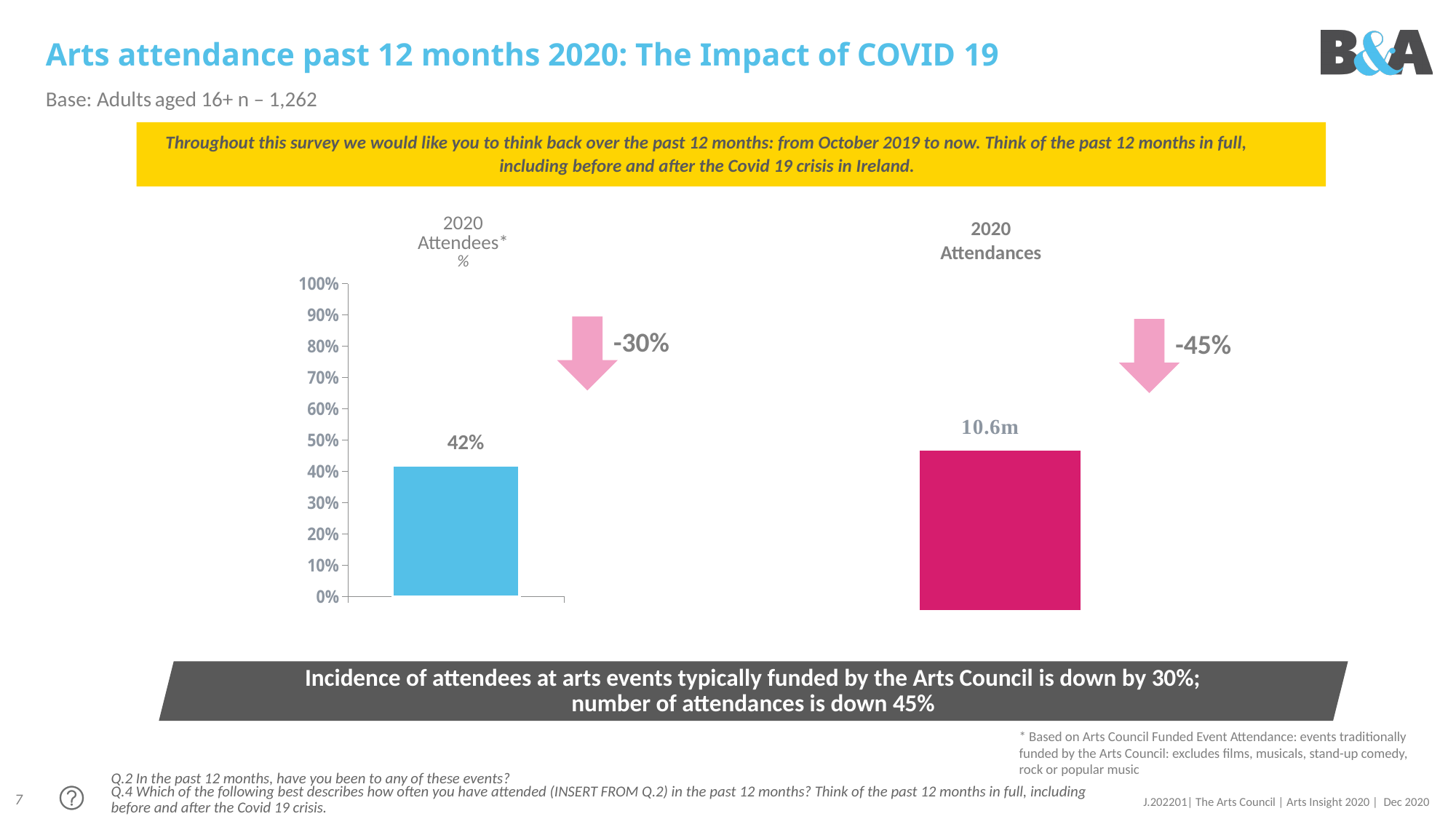
What percentage change is shown by the arrow next to the left chart titled '2020 Attendees %'? -30% What kind of chart is the left chart titled '2020 Attendees %'? bar chart What percentage change is shown by the arrow next to the right chart titled '2020 Attendances'? -45% In the left chart titled '2020 Attendees %', is the value of the bar greater or less than 50%? less What colour is the bar in the left chart titled '2020 Attendees %'? blue Which chart shows the larger percentage decline, '2020 Attendees %' or '2020 Attendances'? 2020 Attendances In the right chart titled '2020 Attendances', what value is printed above the bar? 10.6m How many bars are plotted in the right chart titled '2020 Attendances'? 1 In the left chart titled '2020 Attendees %', what value is shown for the bar? 42% How many bars are plotted in the left chart titled '2020 Attendees %'? 1 What is the maximum value shown on the y axis of the left chart titled '2020 Attendees %'? 100% In the left chart titled '2020 Attendees %', is the value of the bar greater or less than 40%? greater